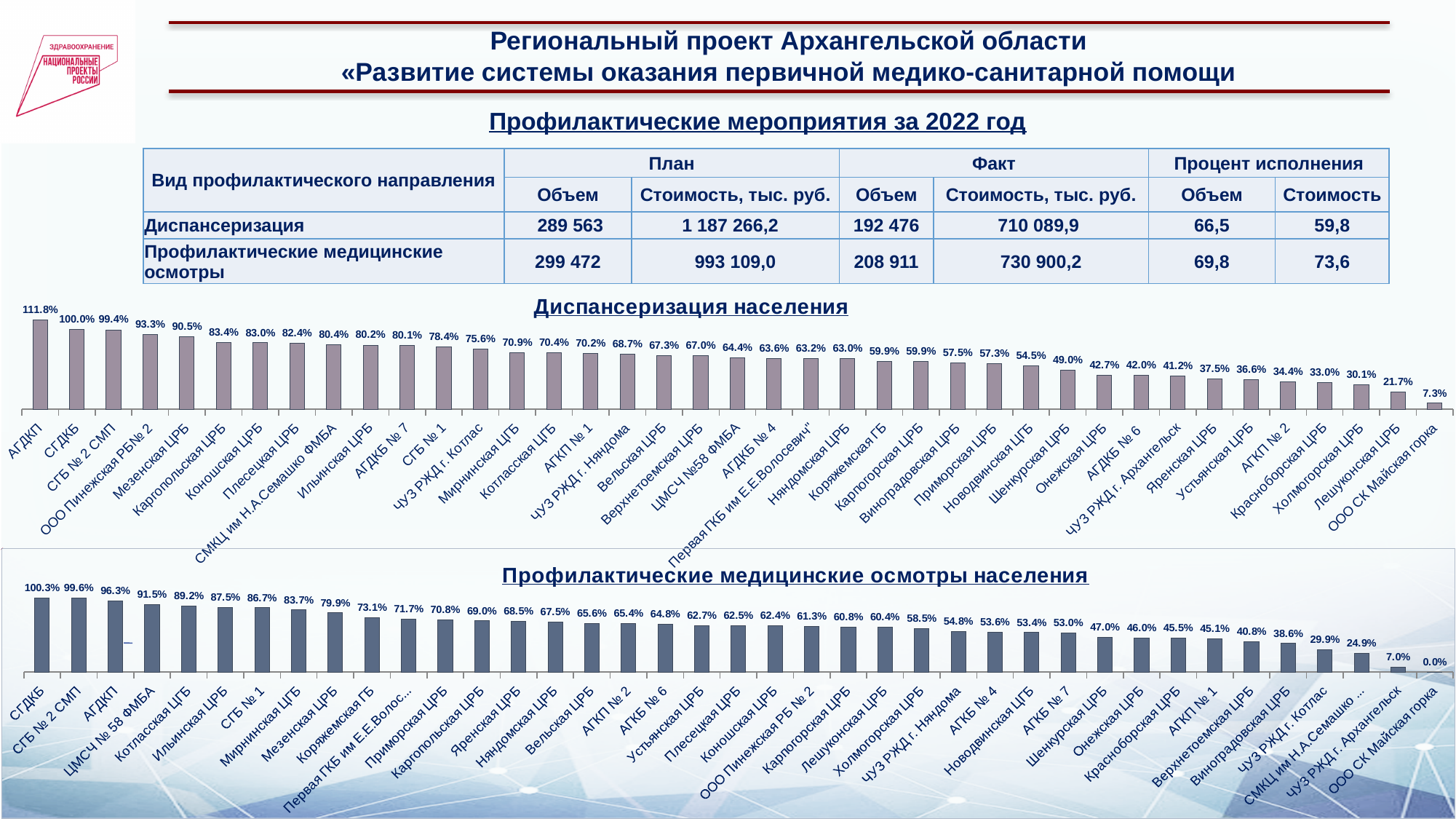
What kind of chart is "Диспансеризация населения"? bar chart In the chart "Профилактические медицинские осмотры населения", what is the difference between the values for Котласская ЦГБ and Ильинская ЦРБ? 1.7% In the chart "Профилактические медицинские осмотры населения", what is the value for Холмогорская ЦРБ? 58.5% In the chart "Профилактические медицинские осмотры населения", do the values rise or fall from left to right along the x axis? fall In the chart "Диспансеризация населения", what is the value for Мезенская ЦРБ? 90.5% In the chart "Диспансеризация населения", which is larger: the value for Шенкурская ЦРБ or the value for Онежская ЦРБ? Шенкурская ЦРБ In the chart "Диспансеризация населения", which category has the lowest value? ООО СК Майская горка In the chart "Профилактические медицинские осмотры населения", which category has the highest value? СГДКБ In the chart "Диспансеризация населения", what is the value for АГДКП? 111.8% In the chart "Профилактические медицинские осмотры населения", what is the value for ЧУЗ РЖД г. Архангельск? 7.0% In the chart "Диспансеризация населения", what is the difference between the values for СГДКБ and Лешуконская ЦРБ? 78.3% In the chart "Профилактические медицинские осмотры населения", what is the value for СГДКБ? 100.3%